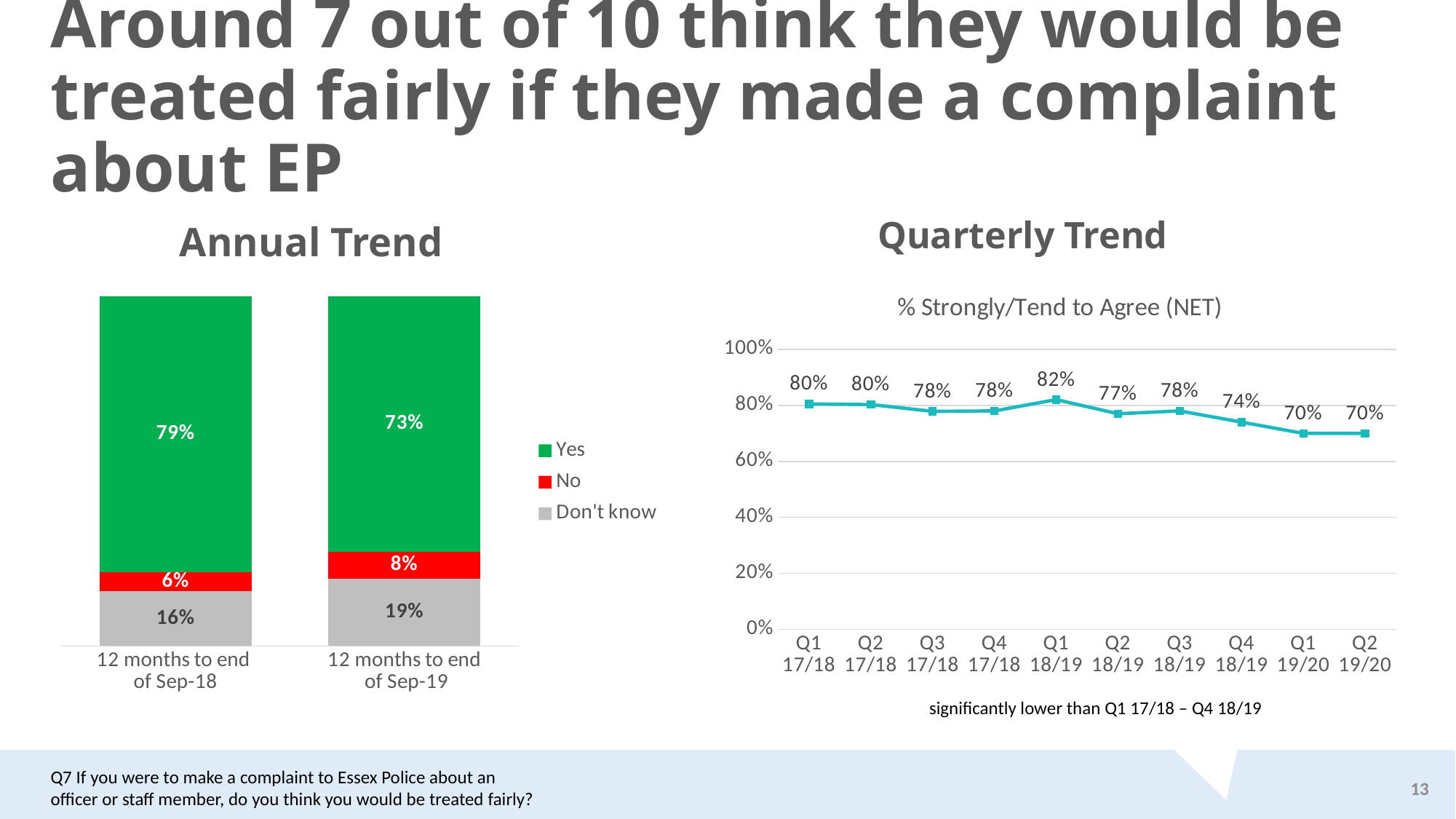
In the Quarterly Trend chart, which quarter has the highest value? Q1 18/19 In the Annual Trend chart, which period has the larger No share, 12 months to end of Sep-18 or 12 months to end of Sep-19? 12 months to end of Sep-19 In the Annual Trend chart, how many series does the legend list? 3 In the Quarterly Trend chart, how many quarters are plotted? 10 In the Quarterly Trend chart, what is the difference between the value for Q1 17/18 and the value for Q2 19/20? 10 percentage points In the Annual Trend chart, what is the difference between the Yes share for Sep-18 and the Yes share for Sep-19? 6 percentage points What kind of chart is the Annual Trend chart? Stacked bar chart In the Quarterly Trend chart, do the values generally rise or fall from Q1 17/18 to Q2 19/20? Fall In the Quarterly Trend chart, what is the value for Q1 18/19? 82% In the Annual Trend chart, what percentage answered Don't know in the 12 months to end of Sep-18? 16% In the Annual Trend chart, what is the total of the stacked bar for 12 months to end of Sep-19? 100% In the Annual Trend chart, what percentage answered Yes in the 12 months to end of Sep-19? 73%